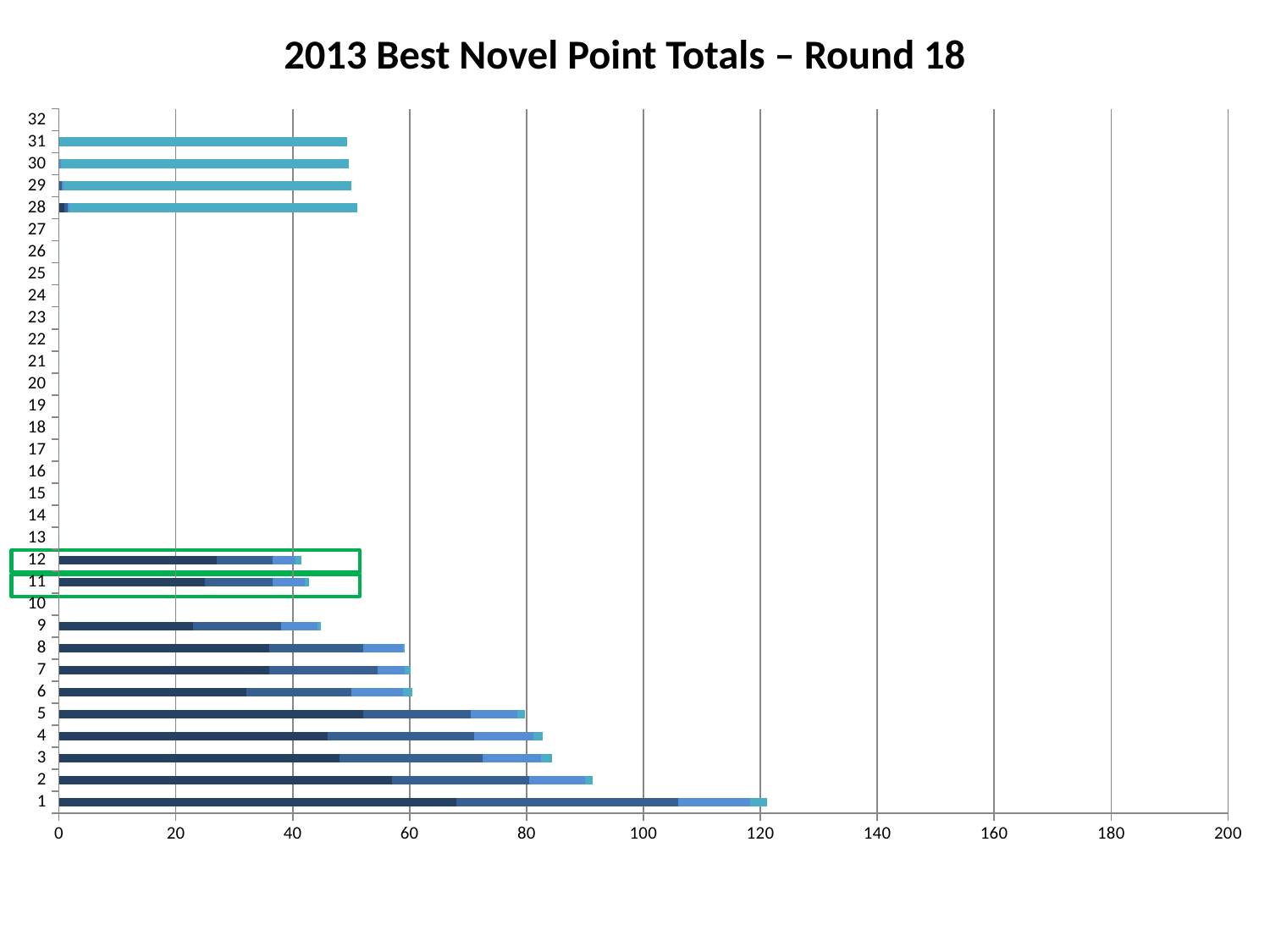
What kind of chart is shown on the slide? bar chart How many categories are listed on the vertical axis of the chart? 32 Is the value for category 31 greater or less than 60? less Is the total value for category 9 greater or less than 40? greater Is the total value for category 2 greater or less than 80? greater Which has the larger total, category 8 or category 9? category 8 Which two categories are outlined with green boxes on the chart? 11 and 12 Which category has the longest bar in the chart? 1 What is the title of the chart? 2013 Best Novel Point Totals – Round 18 Which has the larger total, category 2 or category 3? category 2